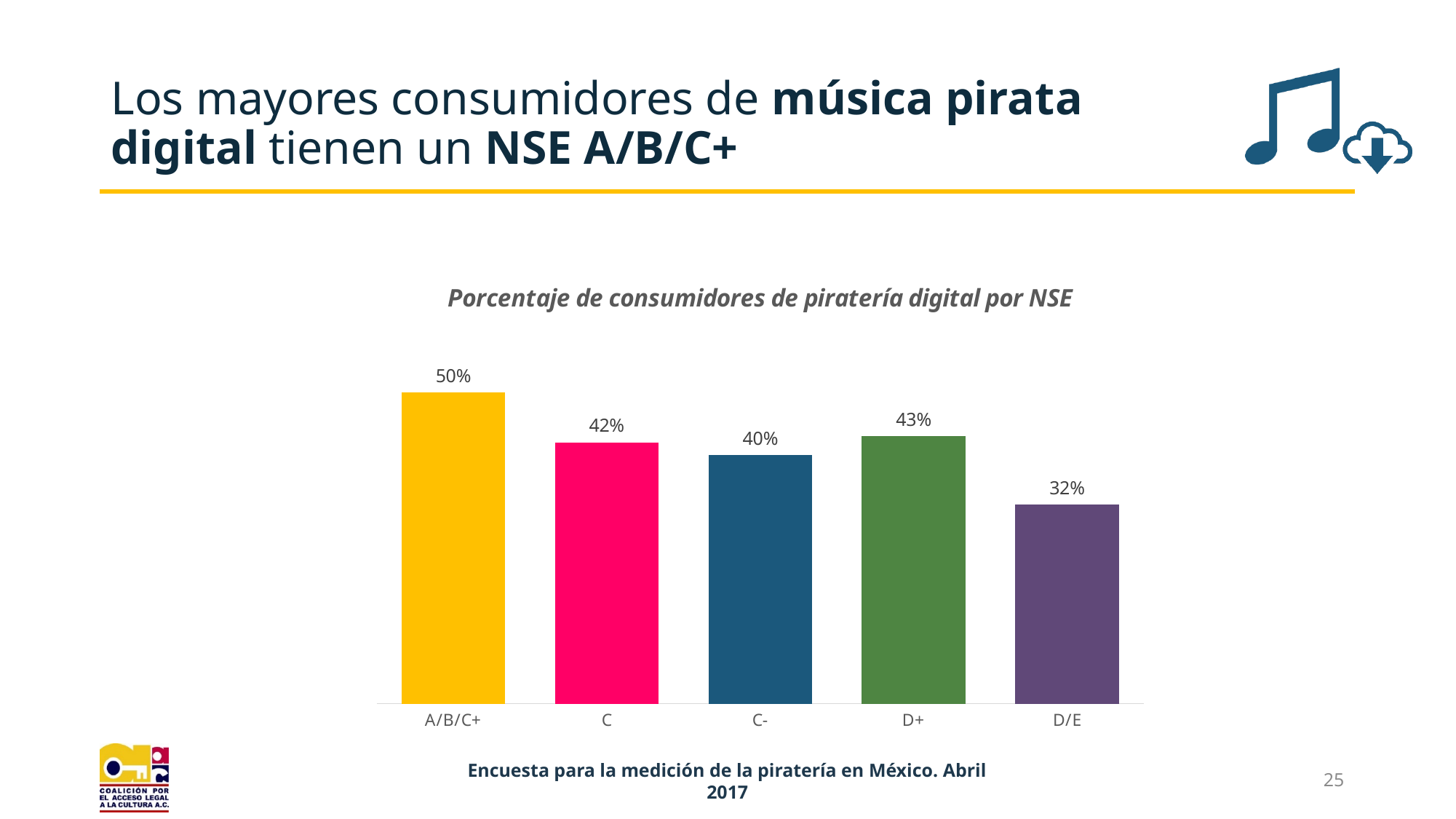
What is the difference between the values for A/B/C+ and D/E? 18% Which category has the highest value? A/B/C+ What is the value for A/B/C+? 50% How many categories are shown on the x axis? 5 What kind of chart is shown on the slide? Bar chart Which is larger, the value for D+ or the value for D/E? D+ What is the difference between the values for C and C-? 2% What is the value for D/E? 32% What is the value for D+? 43% Which category has the lowest value? D/E What is the value for C-? 40% What is the title of the chart? Porcentaje de consumidores de piratería digital por NSE